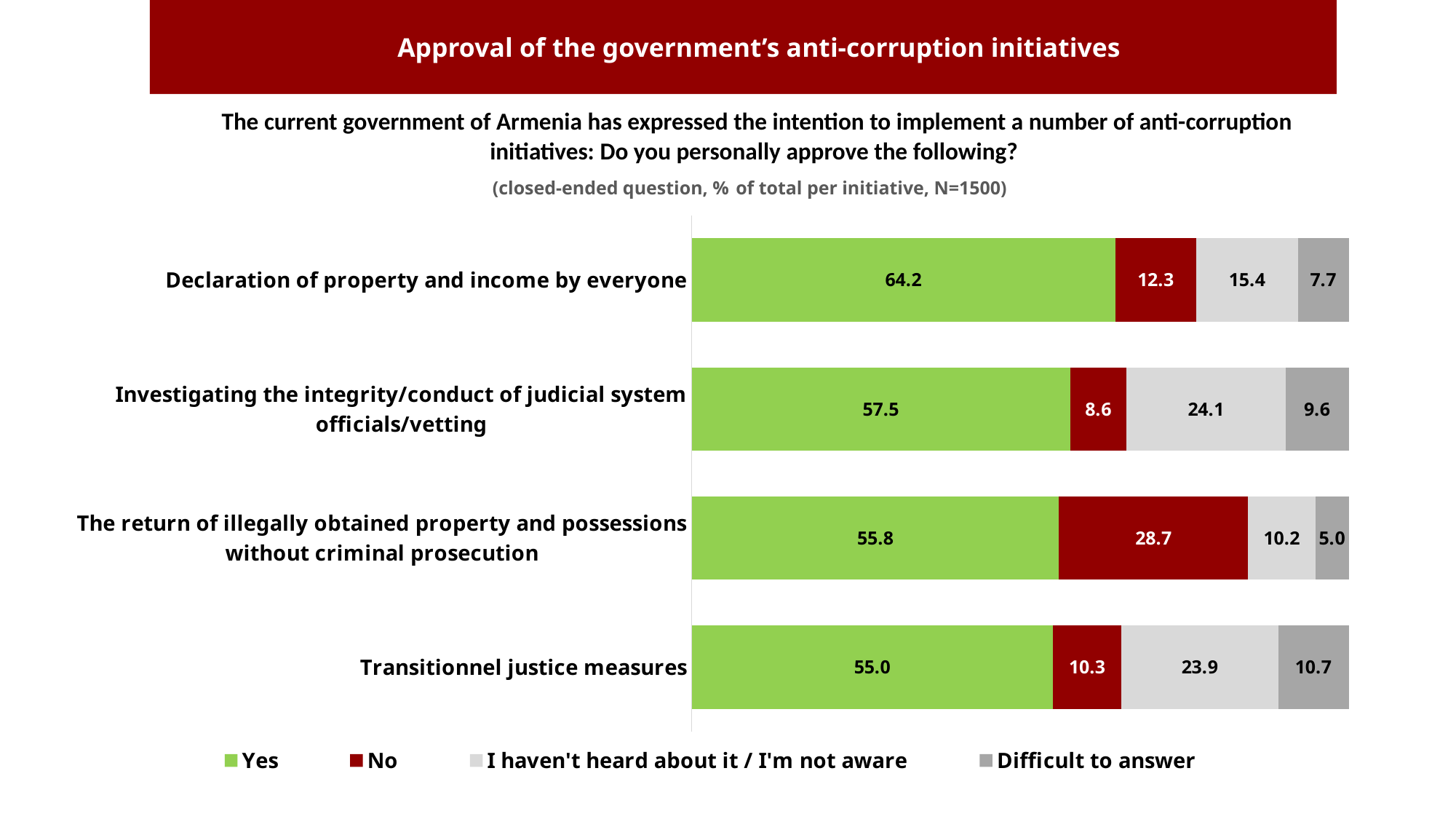
What percentage answered "Yes" for "Declaration of property and income by everyone"? 64.2 Which initiative has the lowest "No" share? Investigating the integrity/conduct of judicial system officials/vetting What is the "I haven't heard about it / I'm not aware" value for "Transitionnel justice measures"? 23.9 How many series does the legend list? 4 What is the difference between the "Yes" values for "Declaration of property and income by everyone" and "Transitionnel justice measures"? 9.2 What is the total of the stacked bar for "The return of illegally obtained property and possessions without criminal prosecution"? 99.7 What is the "Difficult to answer" value for "Investigating the integrity/conduct of judicial system officials/vetting"? 9.6 What kind of chart is shown on the slide? Stacked bar chart Which is larger: the "No" value for "The return of illegally obtained property and possessions without criminal prosecution" or for "Transitionnel justice measures"? The return of illegally obtained property and possessions without criminal prosecution Which initiative has the highest "Yes" share? Declaration of property and income by everyone What is the "No" value for "The return of illegally obtained property and possessions without criminal prosecution"? 28.7 How many initiatives (categories) are shown in the chart? 4